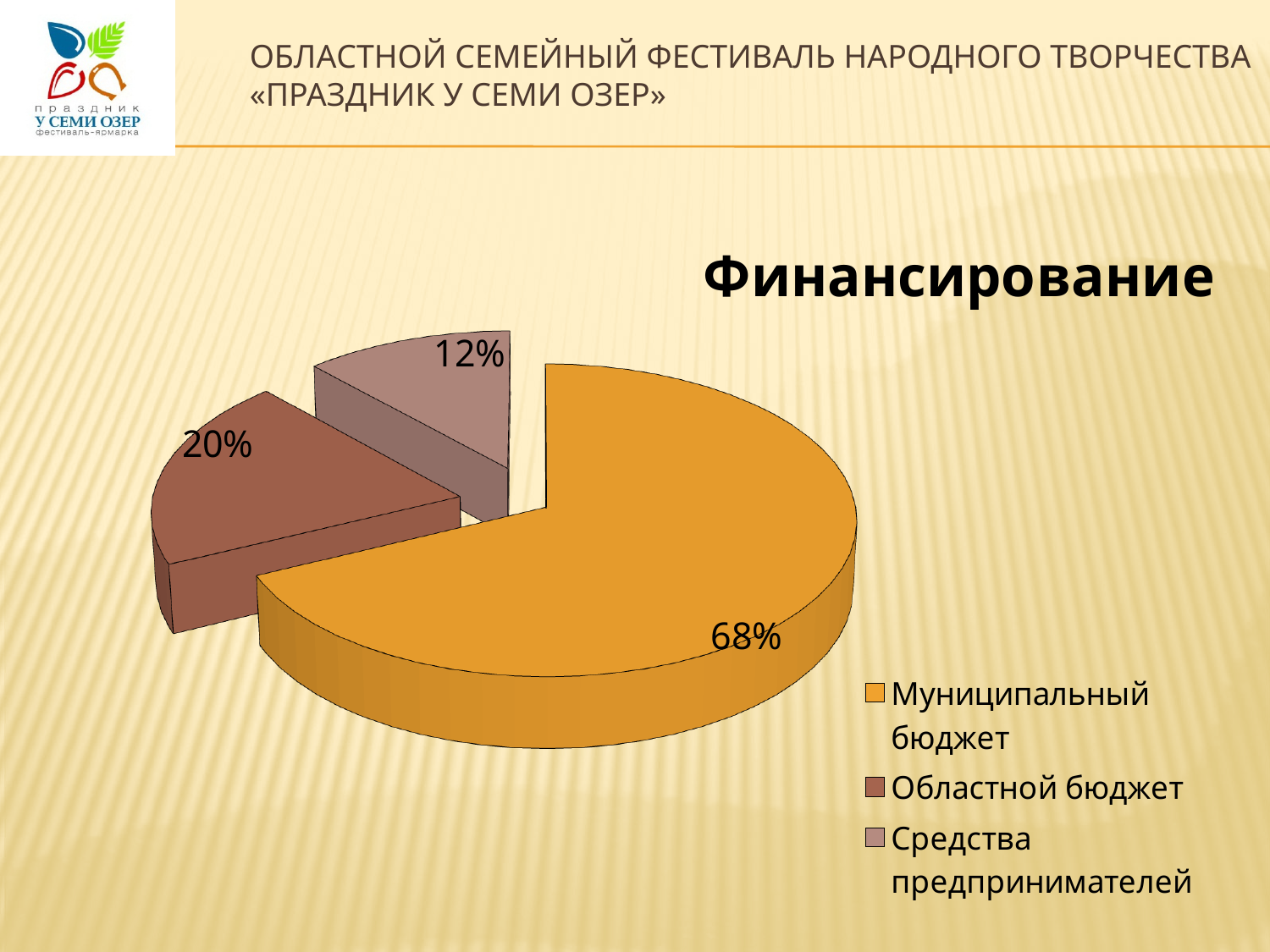
What share of the pie does Средства предпринимателей account for? 12% How many slices does the pie chart have? 3 Which category has the largest slice of the pie? Муниципальный бюджет What share of the pie does Муниципальный бюджет account for? 68% What is the title of the chart? Финансирование What share of the pie does Областной бюджет account for? 20% What type of chart is shown on the slide? Pie chart What is the difference in percentage points between Муниципальный бюджет and Областной бюджет? 48 What is the difference in percentage points between Областной бюджет and Средства предпринимателей? 8 Which is larger: the share for Областной бюджет or the share for Средства предпринимателей? Областной бюджет Which category has the smallest slice of the pie? Средства предпринимателей How many entries does the legend list? 3